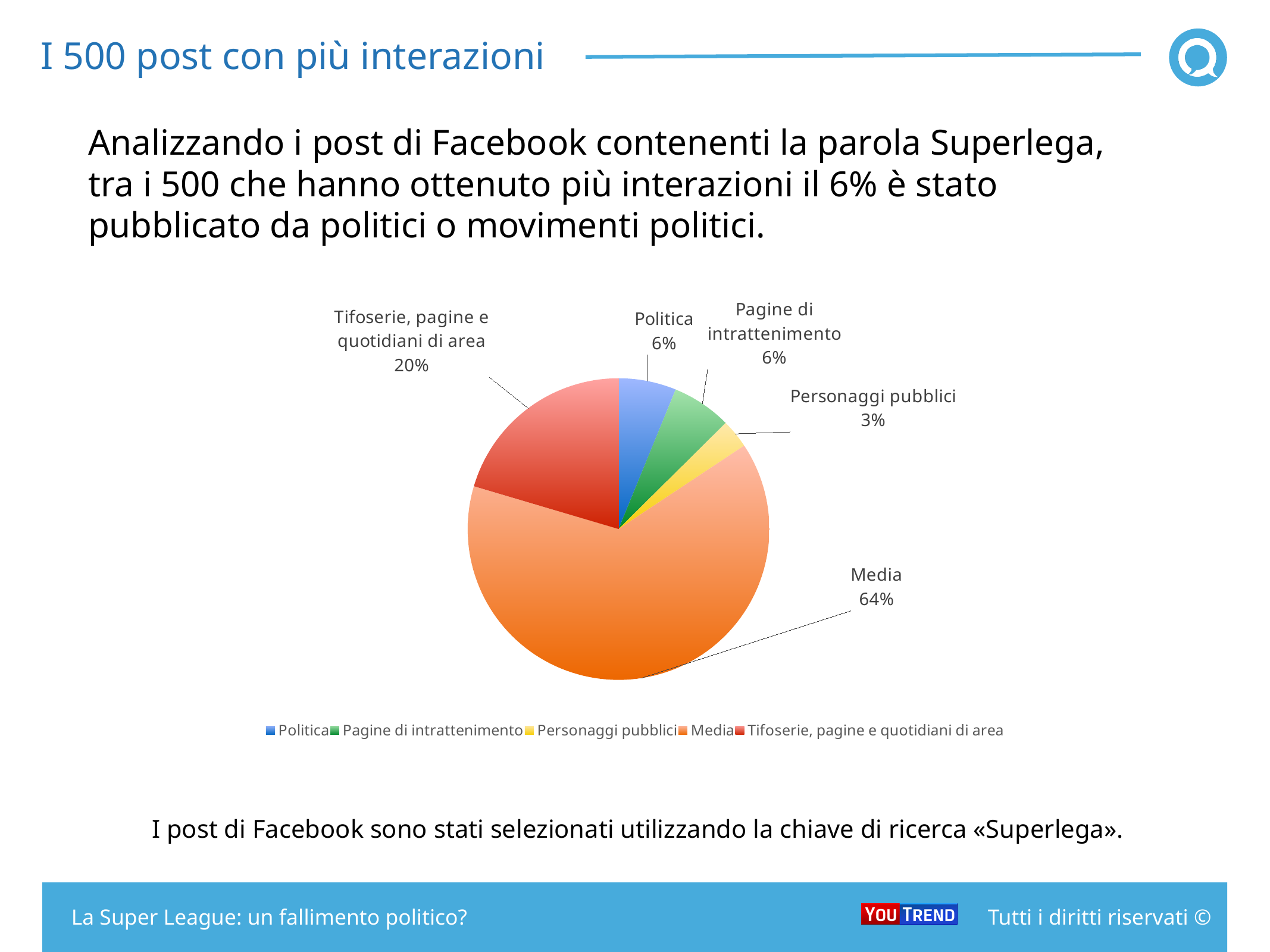
Which is larger, the slice for Tifoserie, pagine e quotidiani di area or the slice for Pagine di intrattenimento? Tifoserie, pagine e quotidiani di area What kind of chart is shown on the slide? Pie chart What percentage is shown for Politica? 6% Which category has the largest slice of the pie? Media What colour is the Media slice in the pie chart? Orange What percentage is shown for Tifoserie, pagine e quotidiani di area? 20% What percentage is shown for Personaggi pubblici? 3% How many categories does the pie chart show? 5 Which category has the smallest slice of the pie? Personaggi pubblici What is the difference in percentage points between Media and Tifoserie, pagine e quotidiani di area? 44 Which legend entry is shown in blue? Politica What share of the pie does Media account for? 64%